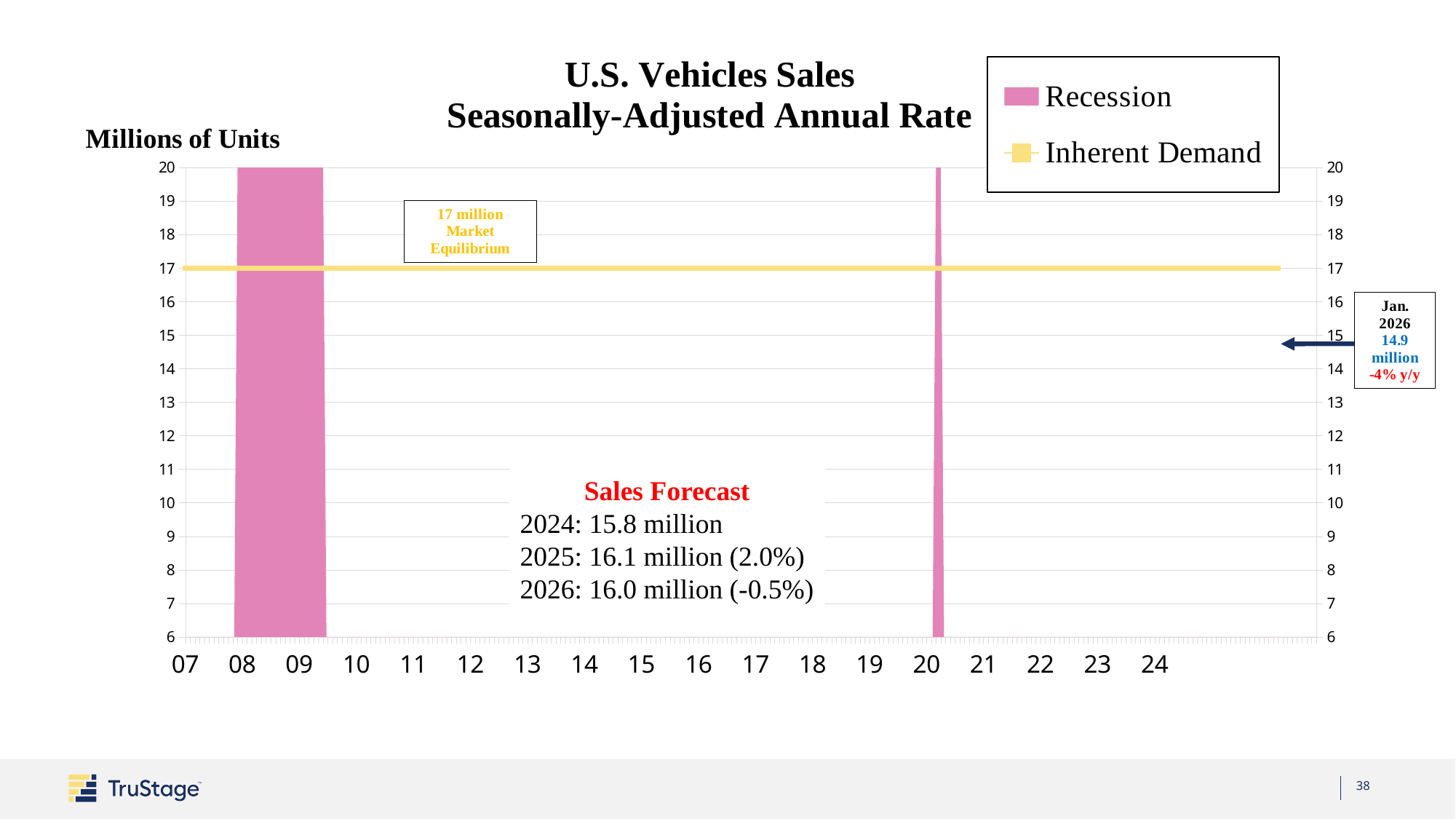
At what level (in millions of units) is the Inherent Demand line drawn? 17 What is the title of the chart? U.S. Vehicles Sales Seasonally-Adjusted Annual Rate What is the sales forecast for 2025? 16.1 million How many series does the legend list? 2 Which is larger: the Jan. 2026 sales value or the Inherent Demand level? Inherent Demand What year-over-year change is shown for Jan. 2026? -4% y/y What is the sales forecast for 2026? 16.0 million What are the two entries in the chart legend? Recession and Inherent Demand Is the Inherent Demand line greater or less than 15 million units? greater How many recession periods are shaded on the chart? 2 What value does the annotation give for U.S. vehicle sales in Jan. 2026? 14.9 million By how much does the 17 million market equilibrium exceed the Jan. 2026 sales value of 14.9 million? 2.1 million